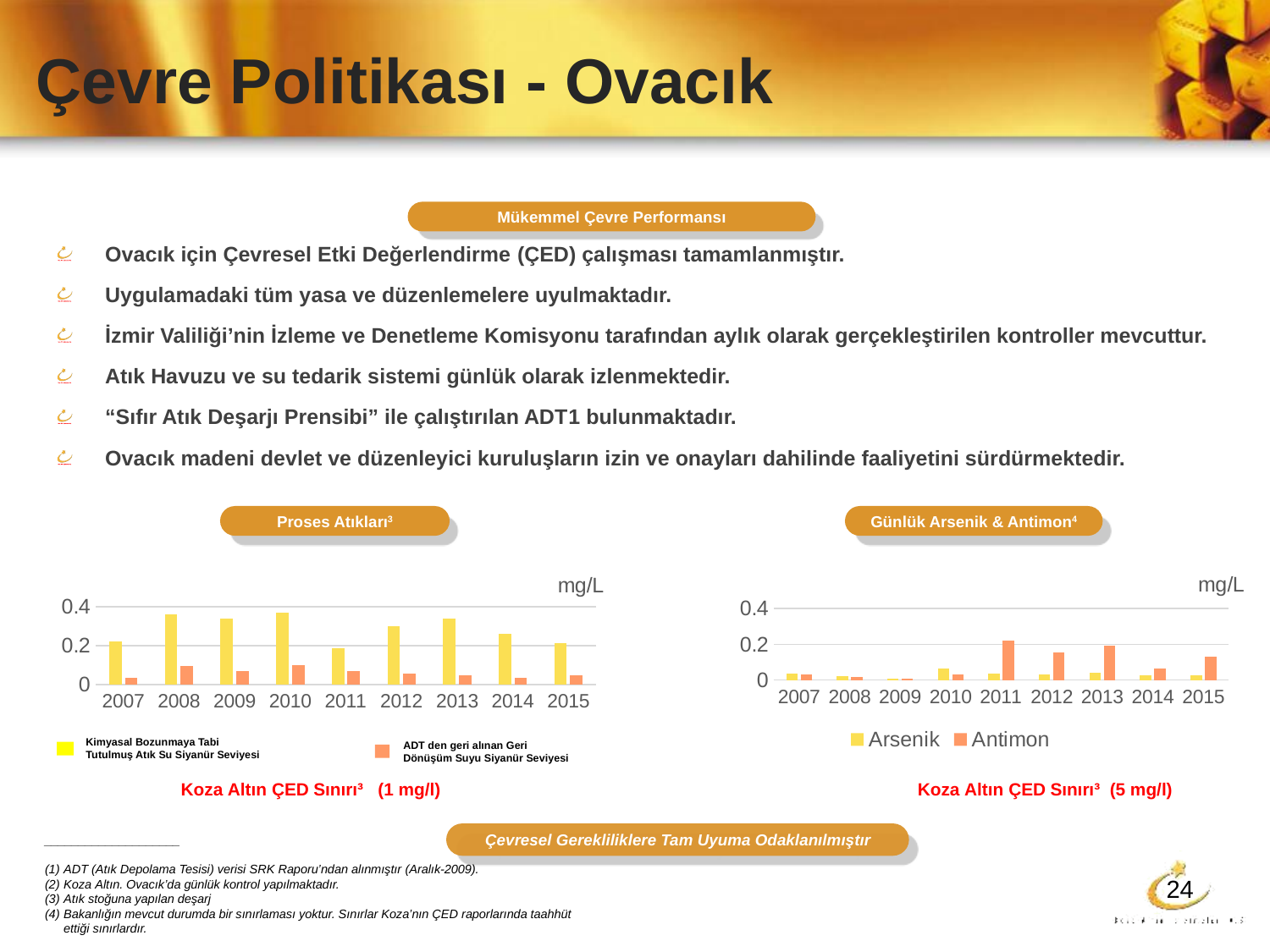
In the 'Proses Atıkları' chart, is the orange bar (ADT den geri alınan Geri Dönüşüm Suyu Siyanür Seviyesi) for 2010 greater or less than 0.2? less What unit is shown on the y axis of the 'Proses Atıkları' chart? mg/L In the 'Günlük Arsenik & Antimon' chart, which year has the larger Antimon value: 2011 or 2014? 2011 In the 'Proses Atıkları' chart, which year has the larger yellow bar (Kimyasal Bozunmaya Tabi Tutulmuş Atık Su Siyanür Seviyesi): 2008 or 2011? 2008 How many series does the legend of the 'Günlük Arsenik & Antimon' chart list? 2 In the 'Proses Atıkları' chart, is the yellow bar (Kimyasal Bozunmaya Tabi Tutulmuş Atık Su Siyanür Seviyesi) for 2008 greater or less than 0.2? greater In the 'Günlük Arsenik & Antimon' chart, what are the two series named in the legend? Arsenik and Antimon In the 'Günlük Arsenik & Antimon' chart, which series has the larger value in 2011: Arsenik or Antimon? Antimon How many years are shown on the x axis of the 'Günlük Arsenik & Antimon' chart? 9 What kind of chart is the 'Proses Atıkları' chart? bar chart